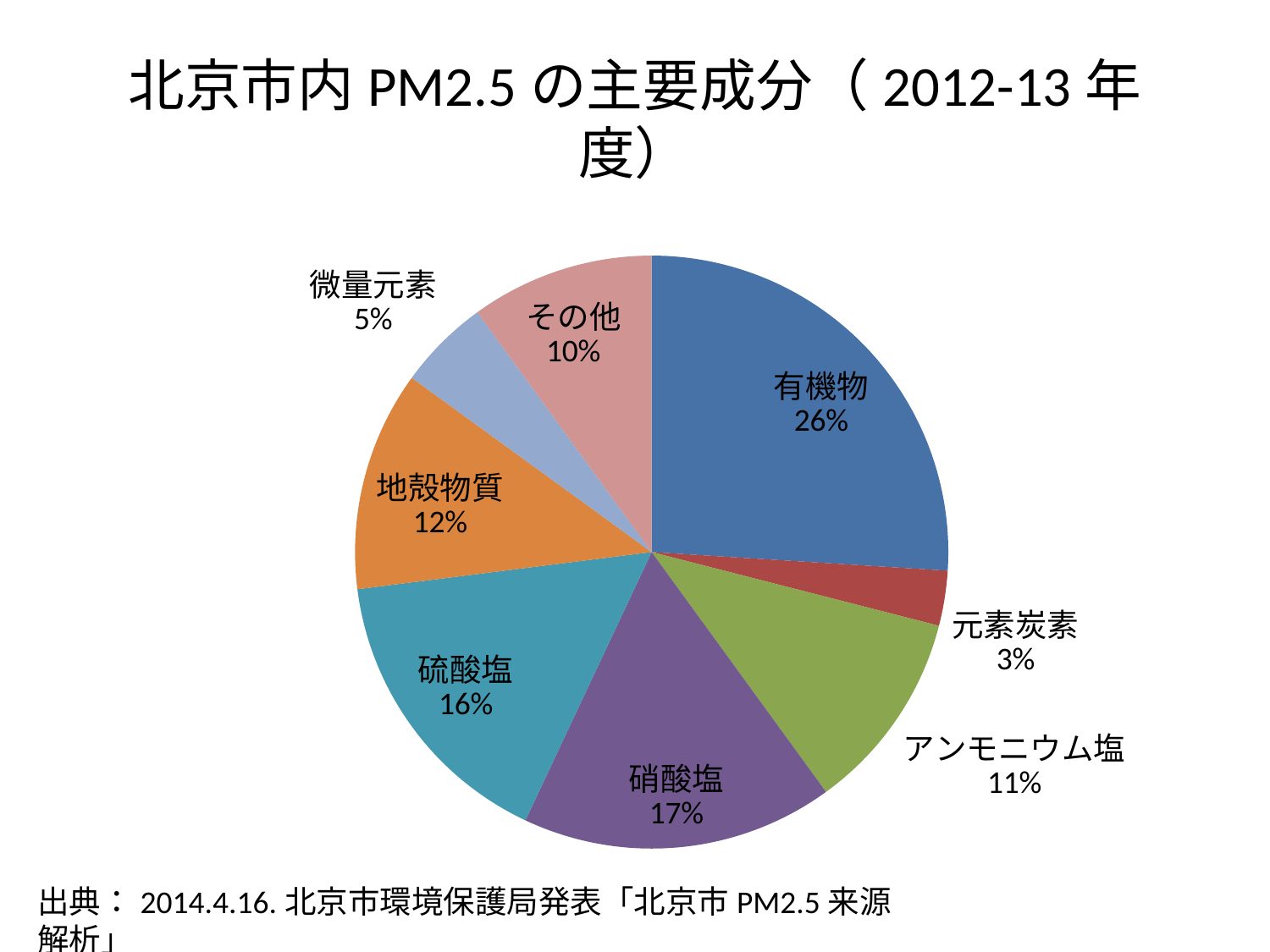
What is the value shown for 硝酸塩? 17% What share of the pie does 有機物 represent? 26% How many slices does the pie chart have? 8 What is the difference in percentage points between 有機物 and 硝酸塩? 9 What kind of chart is shown on the slide? pie chart What is the combined share of 硫酸塩 and 硝酸塩? 33% What is the value shown for 硫酸塩? 16% What is the value shown for アンモニウム塩? 11% Which category has the smallest slice of the pie? 元素炭素 What is the title of the chart? 北京市内 PM2.5 の主要成分（2012-13 年度） Which category has the largest slice of the pie? 有機物 Which is larger, 地殻物質 or 微量元素? 地殻物質